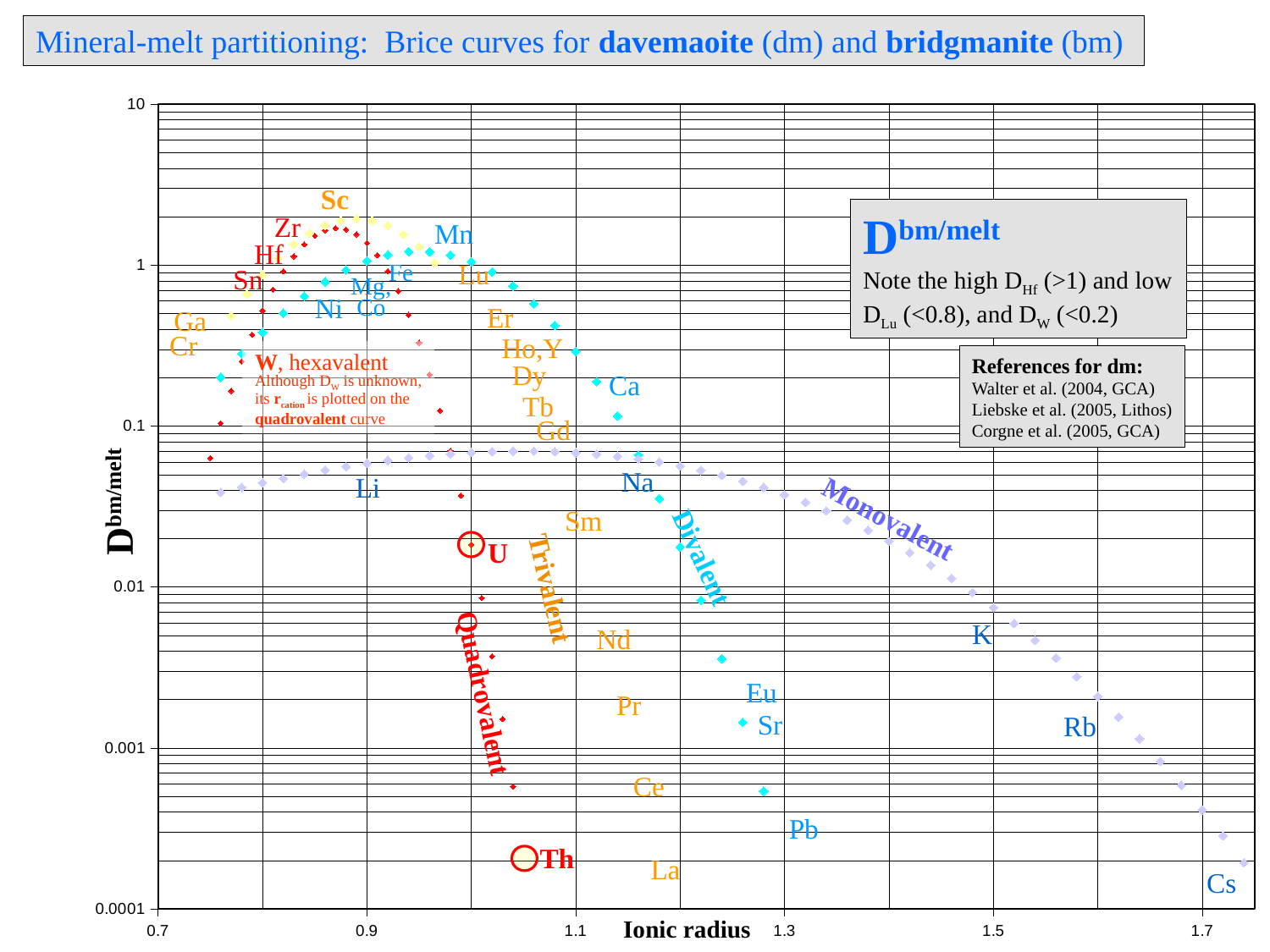
Is the value for K greater or less than 0.01? less Which has the larger value, Hf or Cs? Hf What is the label of the x axis? Ionic radius Is the value for U greater or less than 0.01? greater Is the value for Th greater or less than 0.001? less What kind of chart is shown on the slide? scatter chart What is the label of the y axis? D bm/melt Along the monovalent curve, do the values rise or fall as ionic radius increases from Na to Cs? fall